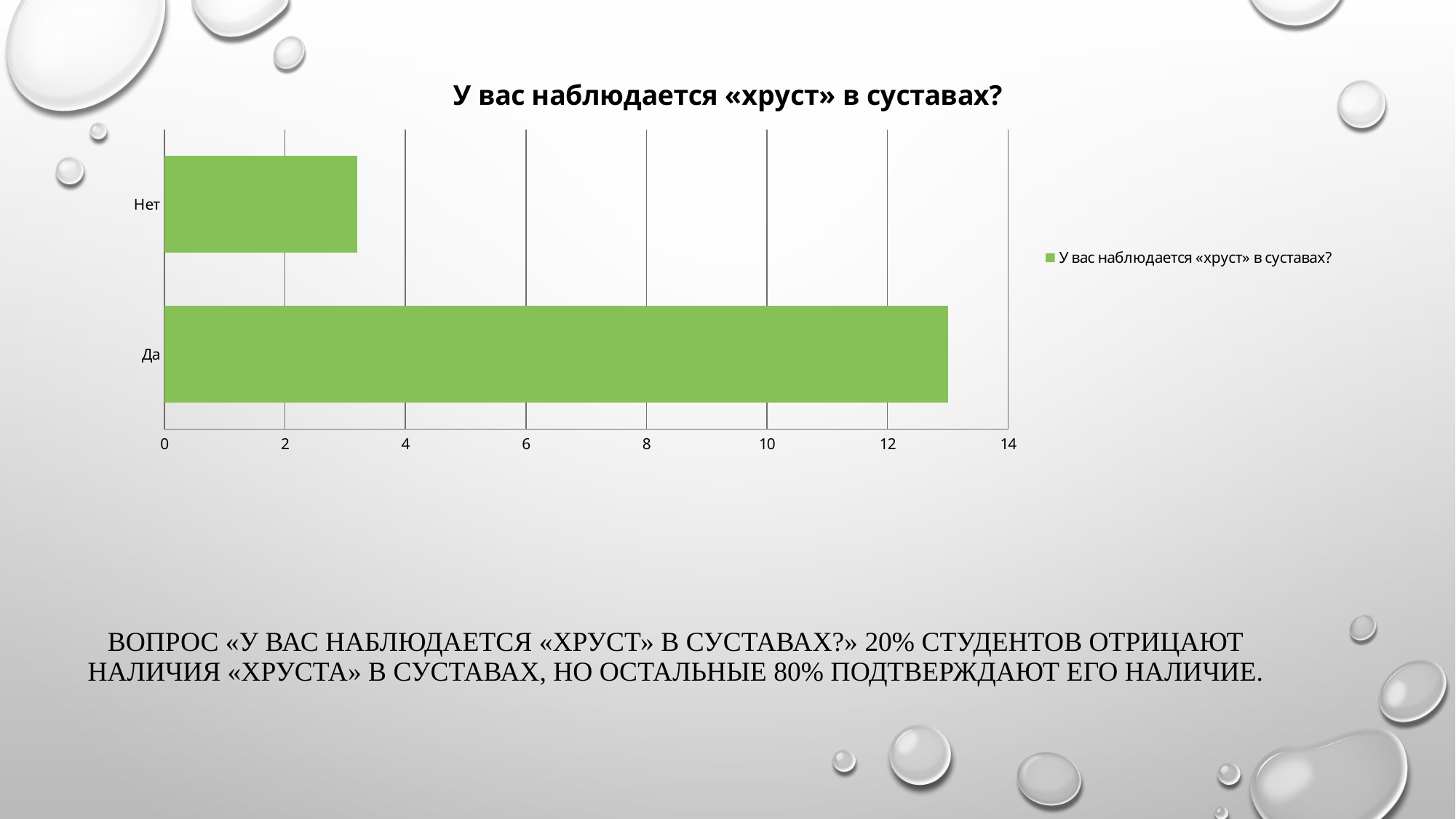
Which category has the lowest value? Нет What is the title of the chart? У вас наблюдается «хруст» в суставах? Is the value for Да greater or less than 14? less Which is larger, the value for Да or the value for Нет? Да Which category has the highest value? Да Is the value for Нет greater or less than 4? less How many categories are plotted in the chart? 2 What kind of chart is shown on the slide? bar chart What colour are the bars in the chart? green Is the value for Да greater or less than 12? greater How many series does the legend list? 1